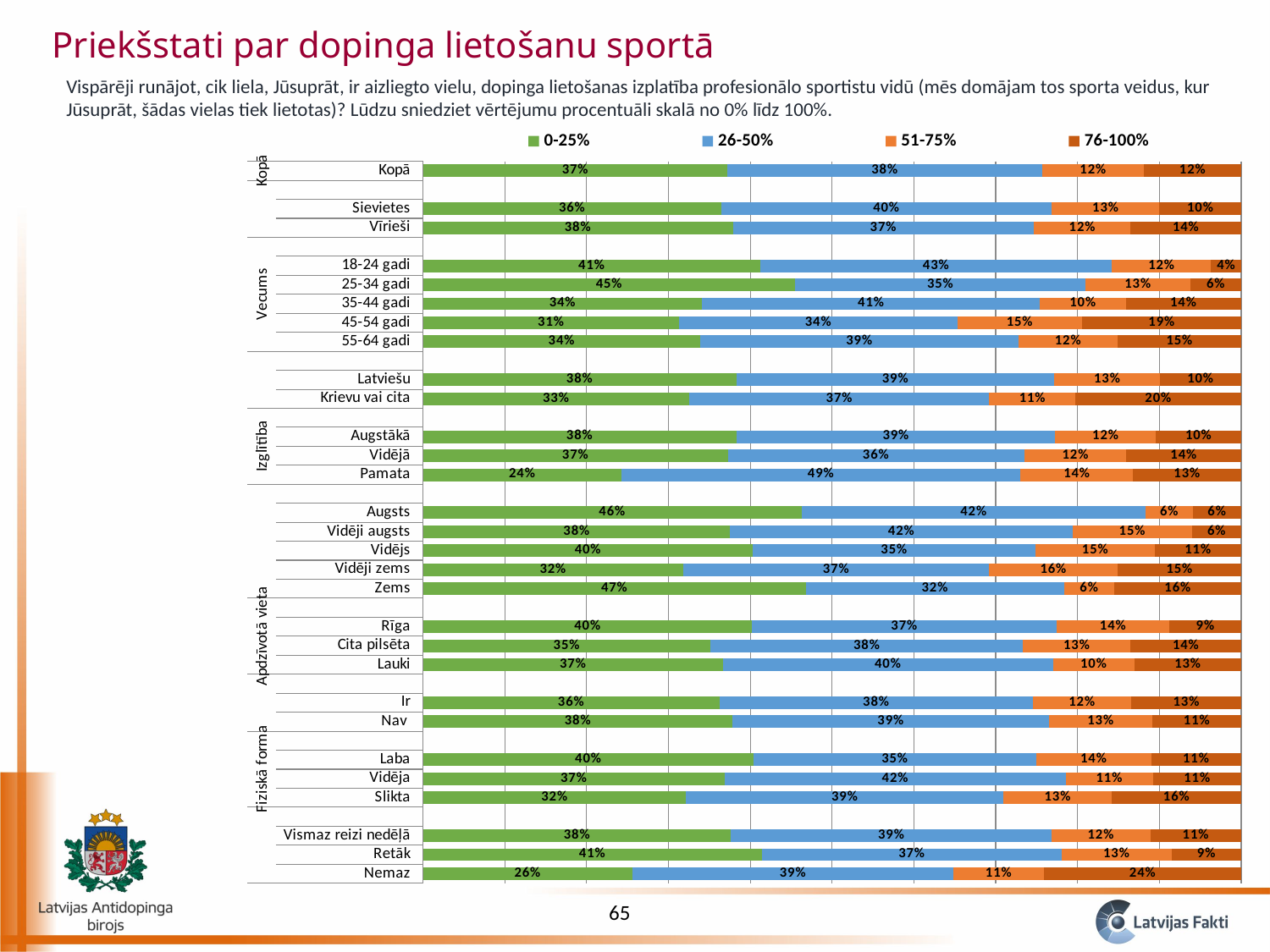
What is the difference between the 26-50% values for Sievietes and Vīrieši? 3 percentage points What is the value of the 76-100% series for the Nemaz category? 24% What kind of chart is shown on the slide? Stacked bar chart How many series does the legend list? 4 What is the value of the 0-25% series for the Kopā category? 37% Which has the larger 76-100% value, Latviešu or Krievu vai cita? Krievu vai cita Which category has the highest value in the 0-25% series? Zems What is the value of the 26-50% series for the Pamata category? 49% Which category has the highest value in the 76-100% series? Nemaz Which category has the lowest value in the 76-100% series? 18-24 gadi What is the value of the 51-75% series for the 45-54 gadi category? 15% Which category has the lowest value in the 0-25% series? Pamata